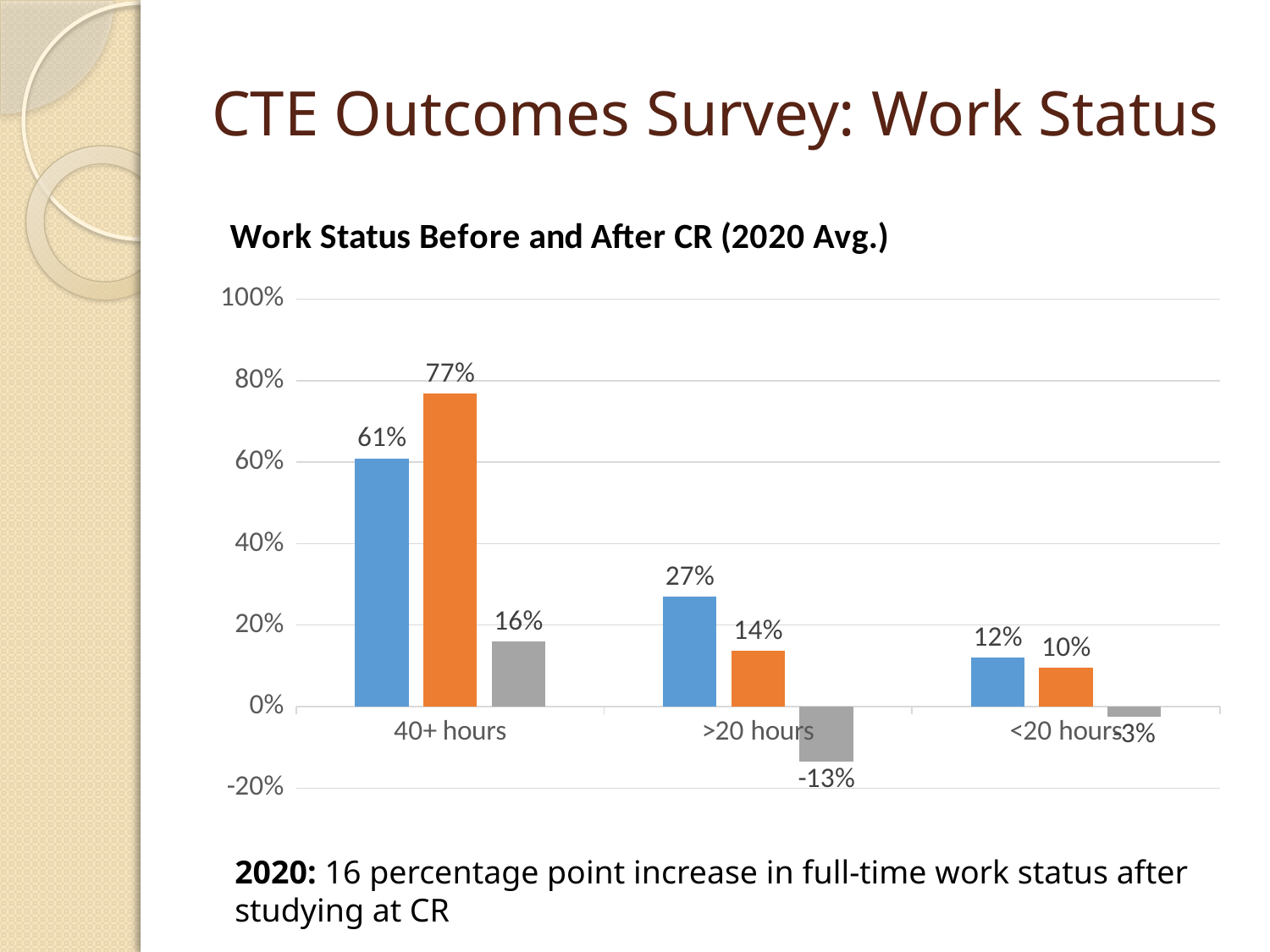
What is the value of the orange bar for >20 hours? 14% Which category has the highest orange bar? 40+ hours What is the value of the orange bar for 40+ hours? 77% What is the difference between the orange bar and the blue bar for 40+ hours? 16 percentage points What is the title of the chart? Work Status Before and After CR (2020 Avg.) What is the value of the blue bar for 40+ hours? 61% How many categories are shown on the x axis of the chart? 3 What is the value of the orange bar for <20 hours? 10% What is the value of the blue bar for >20 hours? 27% What is the value of the gray bar for 40+ hours? 16% What is the value of the gray bar for >20 hours? -13% What kind of chart is shown on the slide? Bar chart